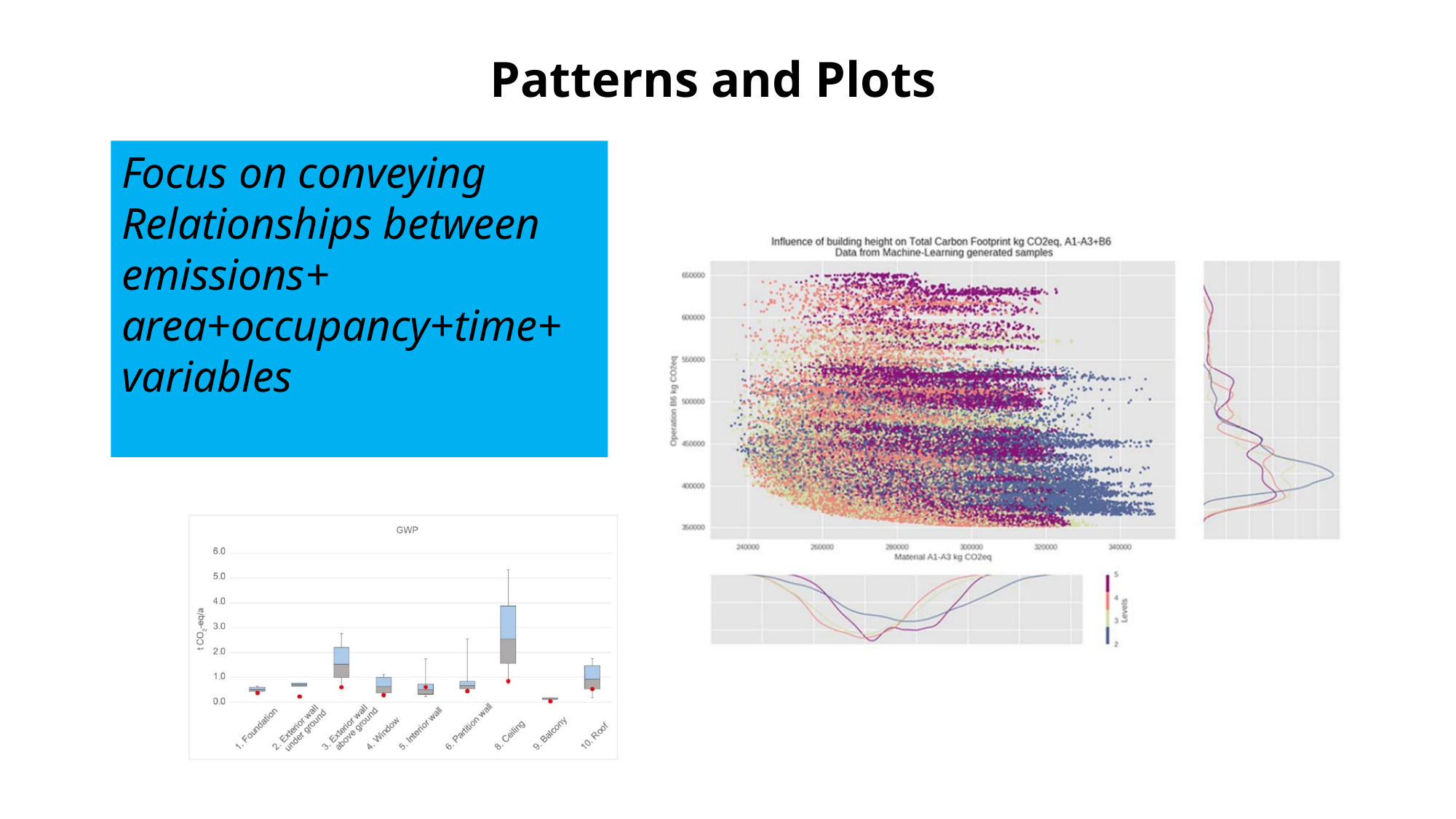
In the GWP box plot, which has a higher box: 8. Ceiling or 4. Window? 8. Ceiling What is the x-axis label of the scatter plot on the right? Material A1-A3 kg CO2eq In the GWP box plot, which category has the lowest values? 9. Balcony What is the y-axis label of the GWP box plot? t CO2-eq/a How many categories are shown on the x axis of the GWP box plot? 9 What is the highest tick value shown on the y axis of the scatter plot on the right? 650000 How many levels does the 'Levels' legend of the scatter plot on the right list? 4 What kind of chart is the large chart on the right titled 'Influence of building height on Total Carbon Footprint'? Scatter plot In the GWP box plot, is the top of the box for 3. Exterior wall above ground greater or less than 2.0? greater What kind of chart is the GWP chart at the bottom left of the slide? Box plot In the GWP box plot, is the top whisker for 8. Ceiling greater or less than 5.0? greater In the GWP box plot, which category has the highest box and whisker values? 8. Ceiling